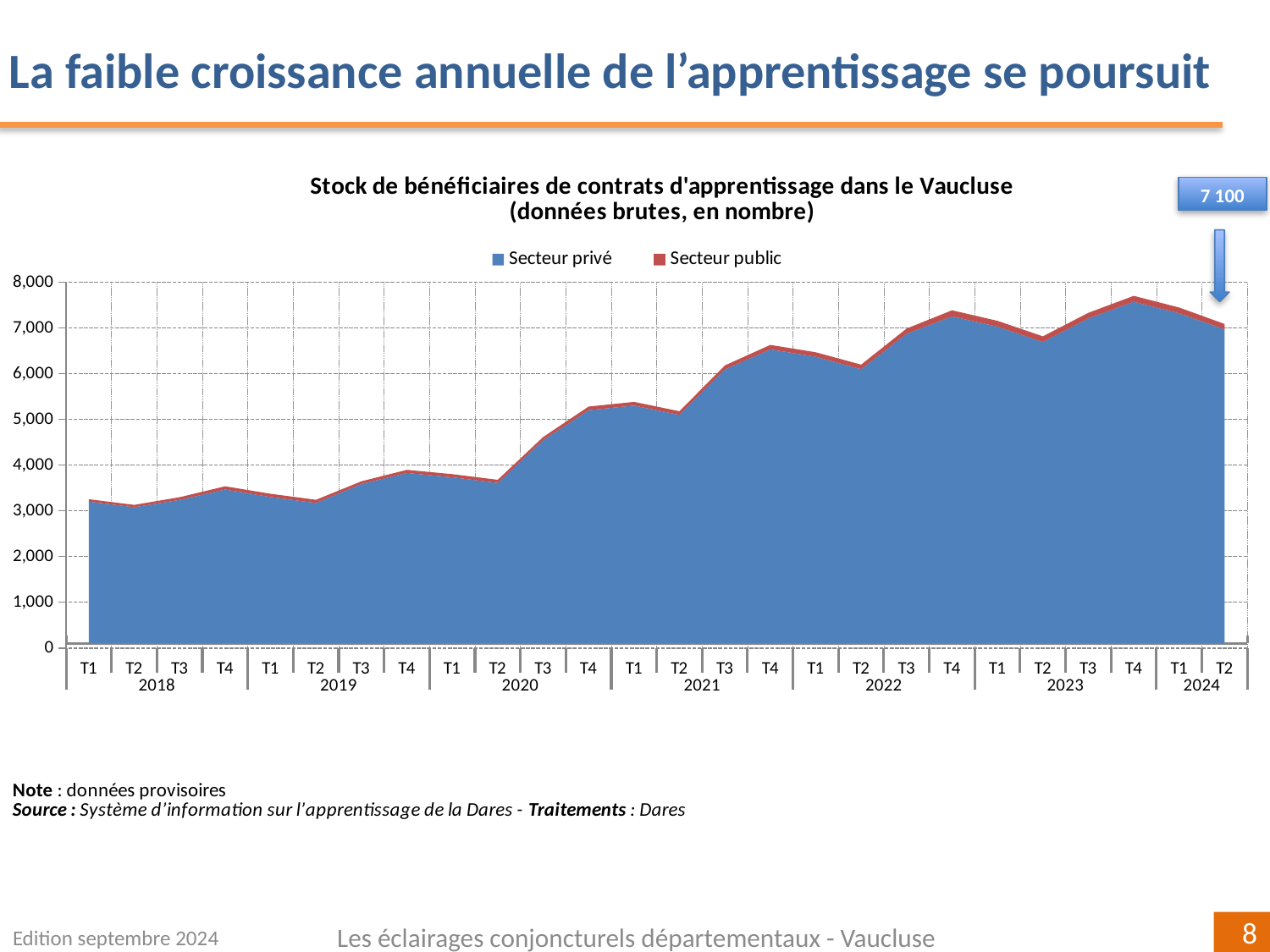
Is the total value for T1 2018 greater or less than 4,000? less Which series is shown in blue? Secteur privé In which quarter does the total stock reach its highest level? T4 2023 Overall, does the total stock rise or fall from 2018 to 2024? Rise Is the total value for T4 2023 greater or less than 7,000? greater Is the total value for T2 2020 greater or less than 4,000? less What kind of chart is shown on the slide? Area chart What is the total stock of apprenticeship beneficiaries indicated for T2 2024? 7 100 How many series does the legend list? 2 Which is larger, the total for T4 2019 or the total for T4 2020? T4 2020 How many quarterly data points are plotted on the x axis? 26